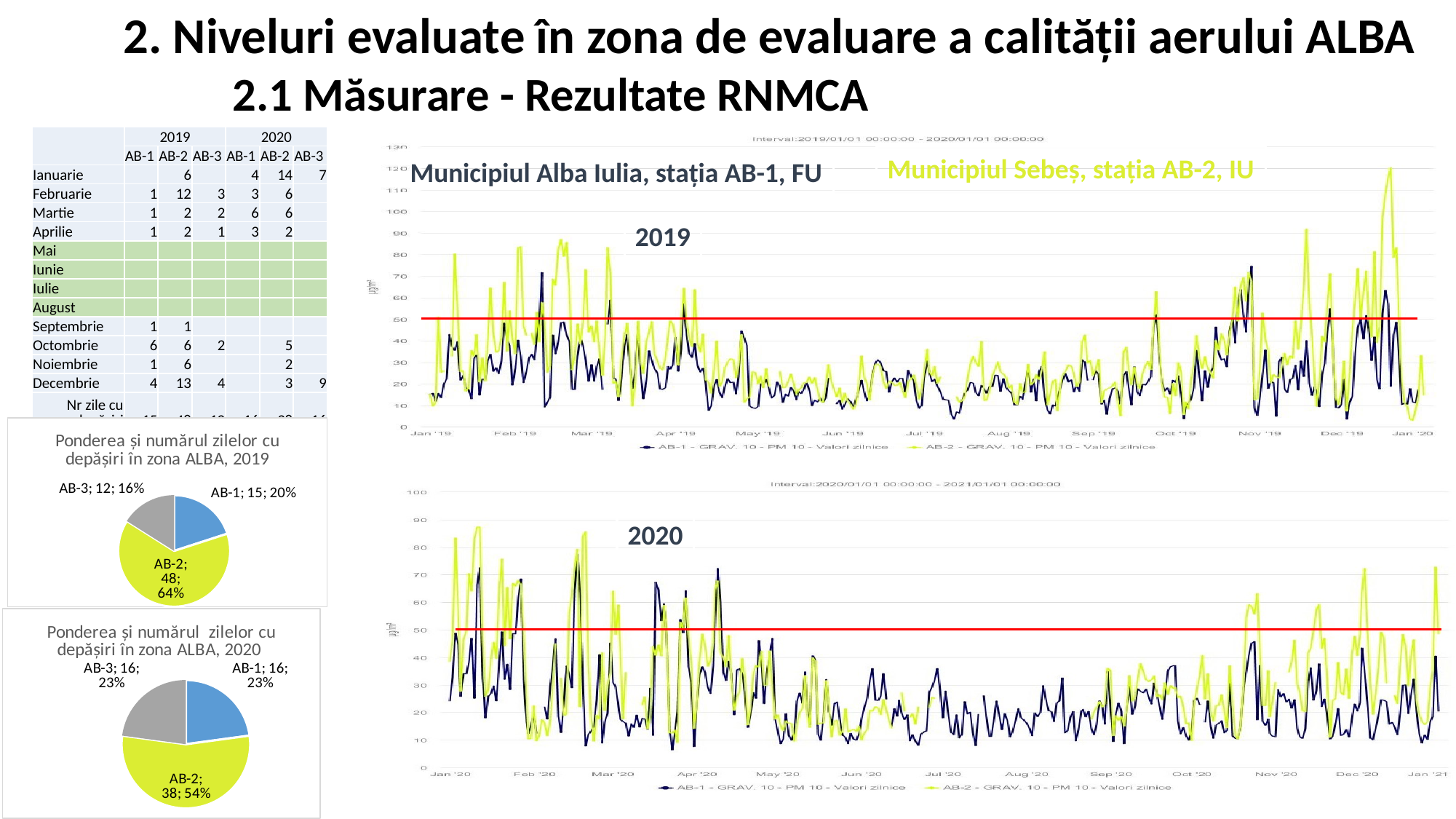
In the pie chart 'Ponderea și numărul zilelor cu depășiri în zona ALBA, 2020', what share does AB-2 have? 54% In the pie chart 'Ponderea și numărul zilelor cu depășiri în zona ALBA, 2020', how many more days does AB-2 have than AB-1? 22 In the pie chart 'Ponderea și numărul zilelor cu depășiri în zona ALBA, 2019', how many days are shown for AB-2? 48 What kind of chart is the 2019 chart on the right side of the slide (Interval 2019/01/01 - 2020/01/01)? line chart How many slices does the pie chart 'Ponderea și numărul zilelor cu depășiri în zona ALBA, 2020' have? 3 How many series does the legend of the 2020 line chart on the right side of the slide list? 2 In the pie chart 'Ponderea și numărul zilelor cu depășiri în zona ALBA, 2019', which has more days, AB-1 or AB-3? AB-1 In the pie chart 'Ponderea și numărul zilelor cu depășiri în zona ALBA, 2019', what share does AB-1 have? 20% In the pie chart 'Ponderea și numărul zilelor cu depășiri în zona ALBA, 2019', what is the total number of days across all three stations? 75 In the pie chart 'Ponderea și numărul zilelor cu depășiri în zona ALBA, 2019', which station has the smallest slice? AB-3 In the pie chart 'Ponderea și numărul zilelor cu depășiri în zona ALBA, 2020', how many days are shown for AB-3? 16 In the pie chart 'Ponderea și numărul zilelor cu depășiri în zona ALBA, 2019', which station has the largest slice? AB-2